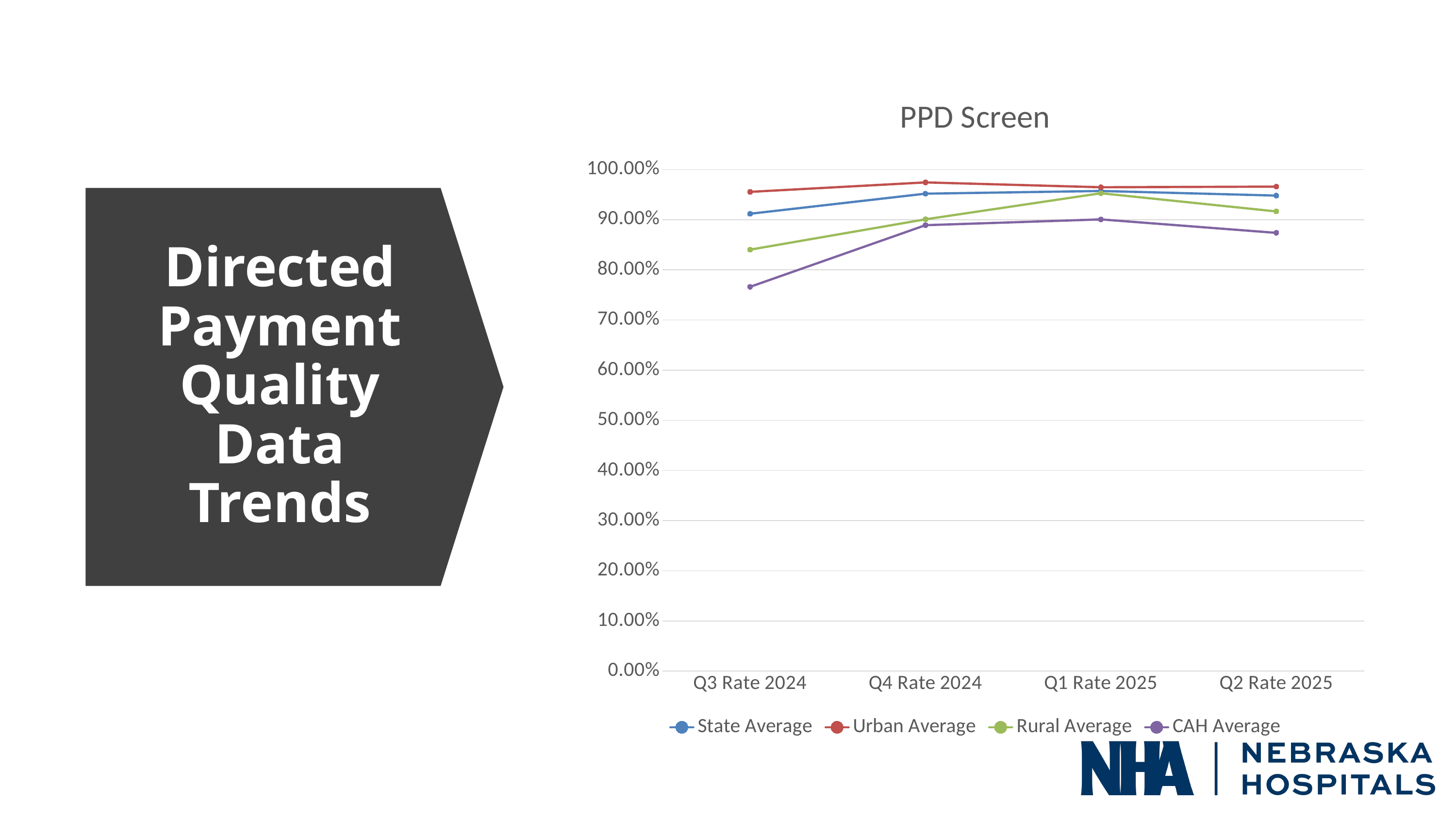
At Q3 Rate 2024, which is larger: Rural Average or CAH Average? Rural Average Is the Rural Average value for Q3 Rate 2024 greater or less than 80.00%? greater Which series has the lowest value at Q3 Rate 2024? CAH Average Is the CAH Average value for Q3 Rate 2024 greater or less than 80.00%? less How many series does the legend list? 4 How many quarters are shown along the x axis? 4 Which series has the highest value at Q3 Rate 2024? Urban Average What kind of chart is shown on the slide? line chart What is the title of the chart? PPD Screen Which colour is used for the Urban Average line? red Is the CAH Average value for Q2 Rate 2025 greater or less than 90.00%? less Does the CAH Average rise or fall from Q3 Rate 2024 to Q4 Rate 2024? rise